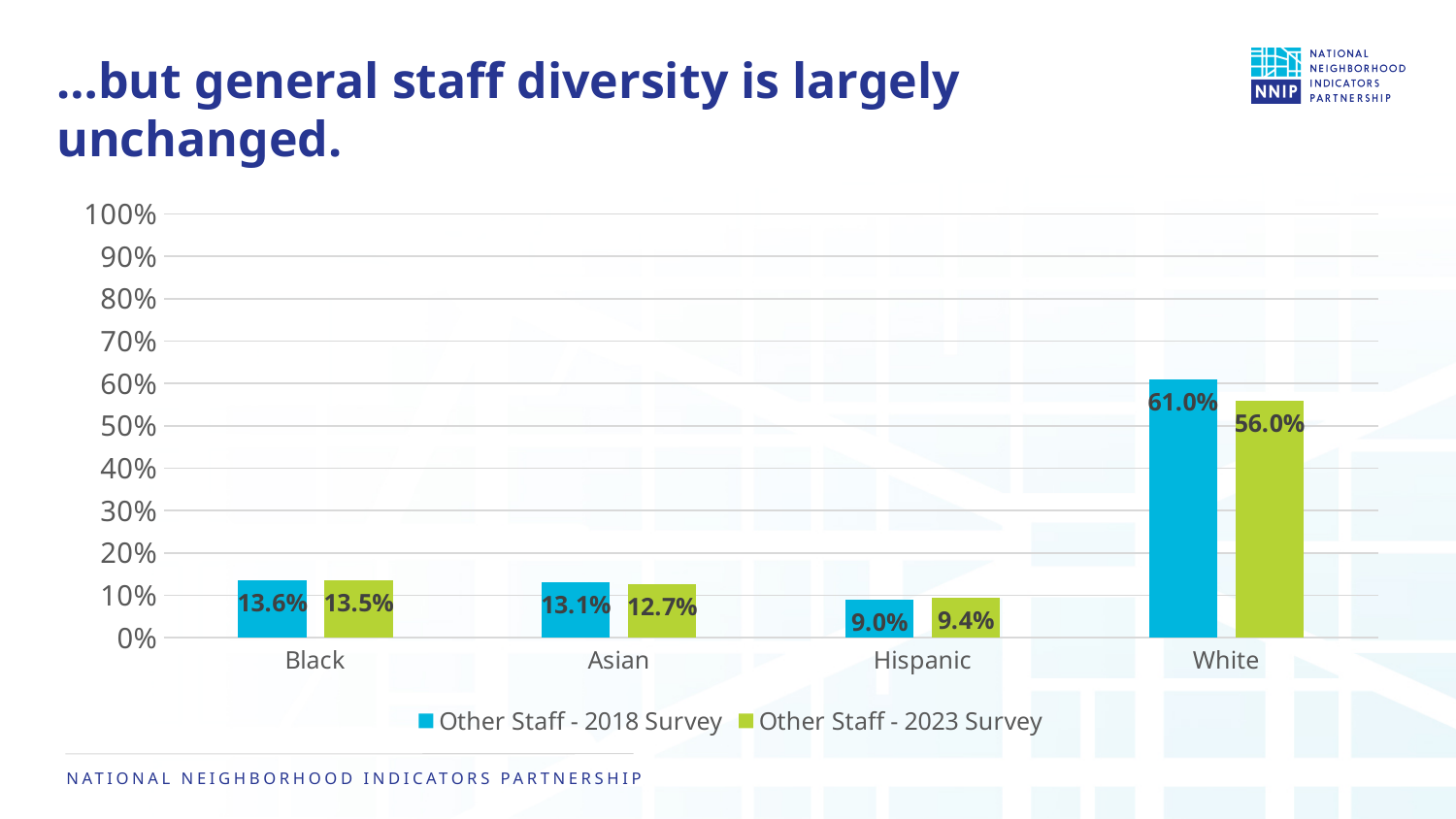
How many categories are shown on the x axis? 4 What colour are the bars for the Other Staff - 2023 Survey series? Green What is the value for Asian in the Other Staff - 2018 Survey series? 13.1% What is the difference between the 2018 Survey and 2023 Survey values for White? 5.0% How many series does the legend list? 2 What is the value for White in the Other Staff - 2018 Survey series? 61.0% Is the value for White in the Other Staff - 2023 Survey series greater or less than 50%? greater Which is larger for Hispanic: the Other Staff - 2018 Survey value or the Other Staff - 2023 Survey value? Other Staff - 2023 Survey What kind of chart is shown on the slide? Bar chart What is the value for Hispanic in the Other Staff - 2023 Survey series? 9.4% Which category has the lowest value in the Other Staff - 2018 Survey series? Hispanic Which category has the highest value in the Other Staff - 2023 Survey series? White